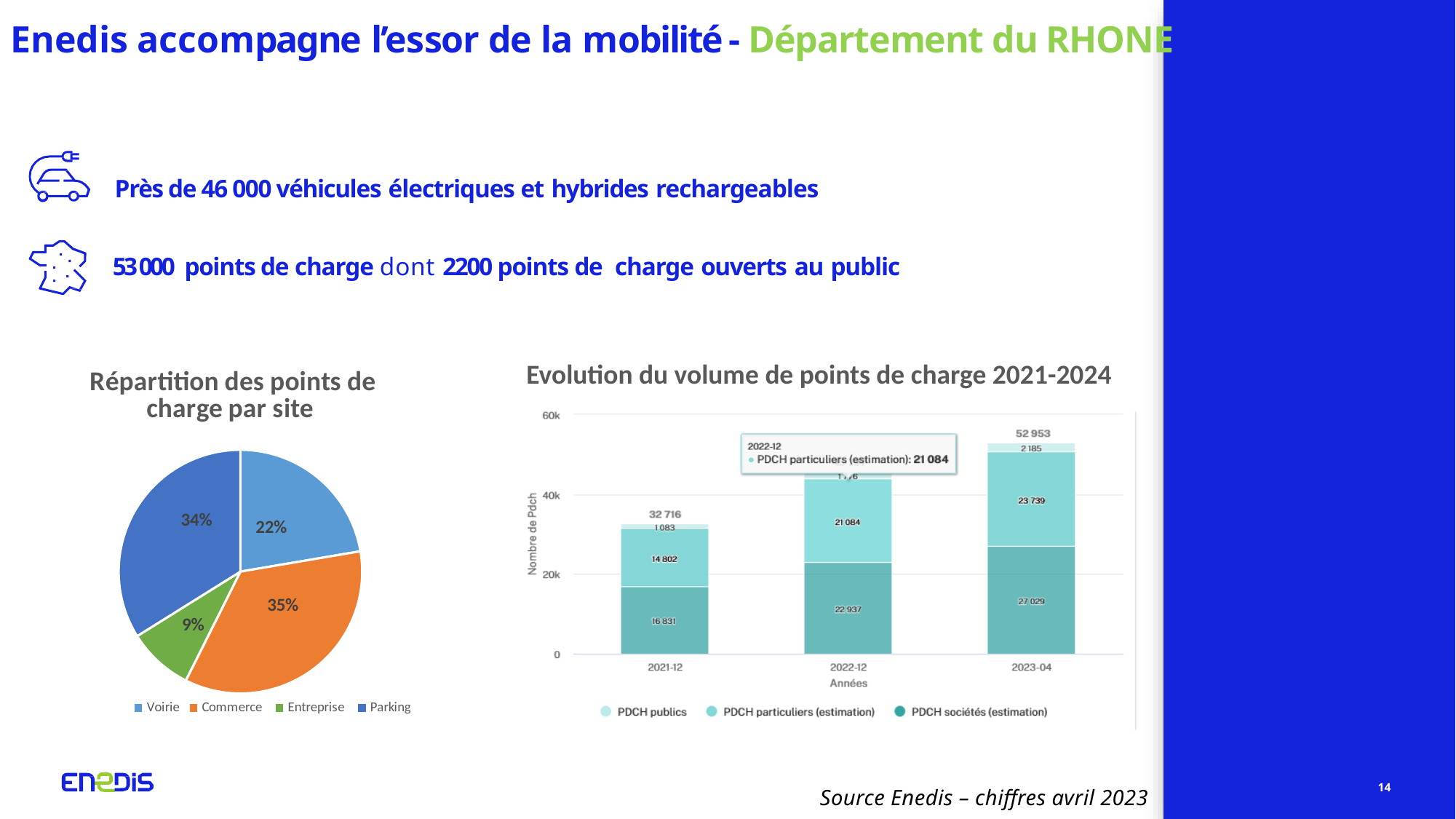
In the chart 'Evolution du volume de points de charge 2021-2024', what is the value of PDCH particuliers (estimation) for 2022-12? 21 084 In the pie chart 'Répartition des points de charge par site', what share is Commerce? 35% In the pie chart 'Répartition des points de charge par site', what is the difference in percentage points between Parking and Voirie? 12 What kind of chart is 'Evolution du volume de points de charge 2021-2024'? stacked bar chart In the chart 'Evolution du volume de points de charge 2021-2024', how many series does the legend list? 3 In the chart 'Evolution du volume de points de charge 2021-2024', what is the value of PDCH sociétés (estimation) for 2023-04? 27 029 In the chart 'Evolution du volume de points de charge 2021-2024', what is the value of PDCH publics for 2023-04? 2 185 In the pie chart 'Répartition des points de charge par site', which site category has the smallest share? Entreprise In the pie chart 'Répartition des points de charge par site', how many categories does the legend list? 4 In the chart 'Evolution du volume de points de charge 2021-2024', do the total values rise or fall from 2021-12 to 2023-04? rise In the chart 'Evolution du volume de points de charge 2021-2024', what is the total number of points de charge for 2021-12? 32 716 In the pie chart 'Répartition des points de charge par site', what share is Entreprise? 9%